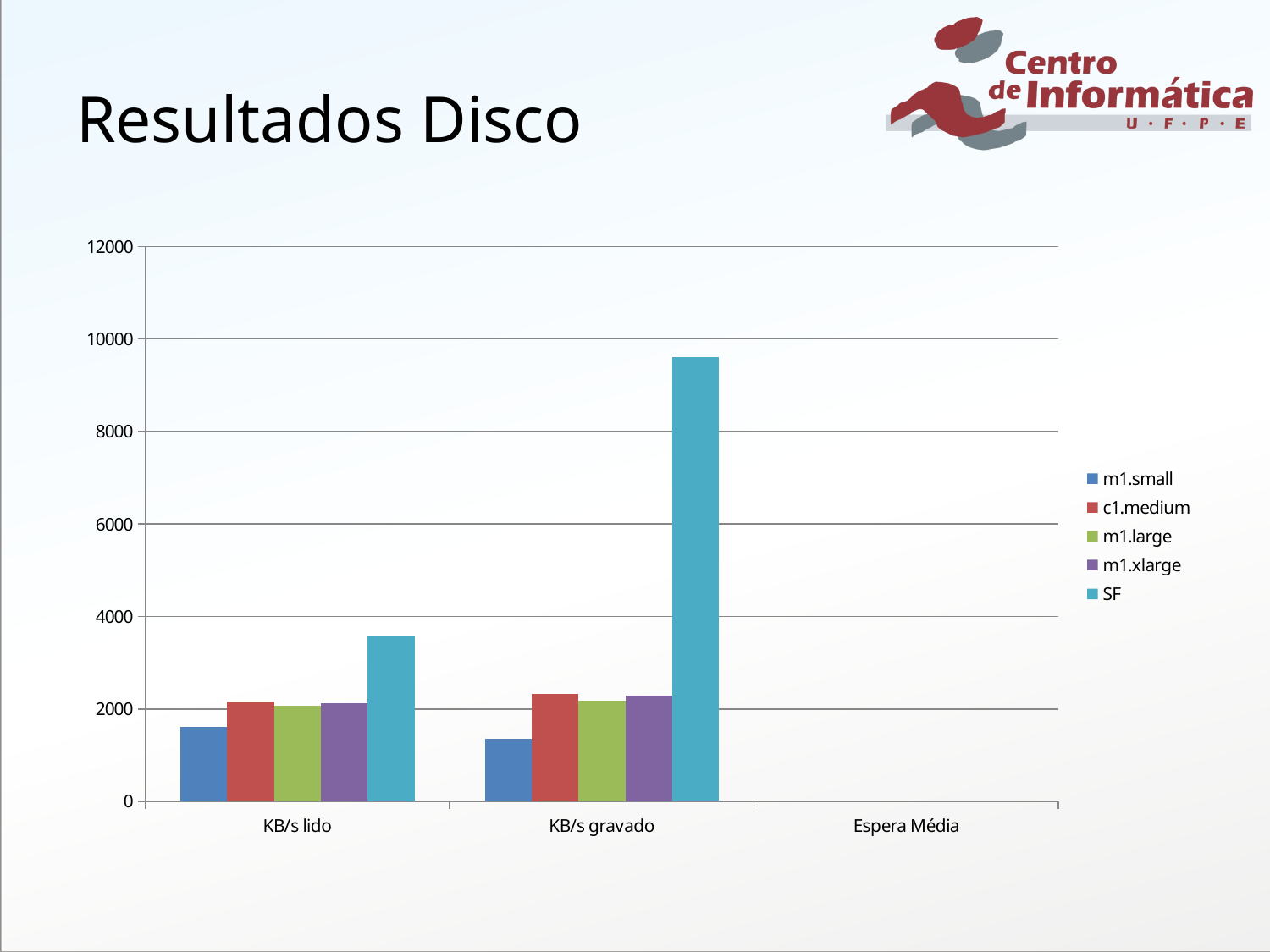
How many series does the legend list? 5 Is the value of SF for KB/s lido greater or less than 4000? less Which series is shown in light blue in the legend? SF Is the value of SF for KB/s gravado larger than its value for KB/s lido? yes Which series has the highest value for KB/s gravado? SF Is the value of SF for KB/s gravado greater or less than 8000? greater Is the value of m1.small for KB/s lido greater or less than 2000? less Which series has the lowest value for KB/s lido? m1.small What kind of chart is shown on the slide? bar chart Which series has the lowest value for KB/s gravado? m1.small How many categories are shown on the x axis? 3 What is the title of the slide containing the chart? Resultados Disco